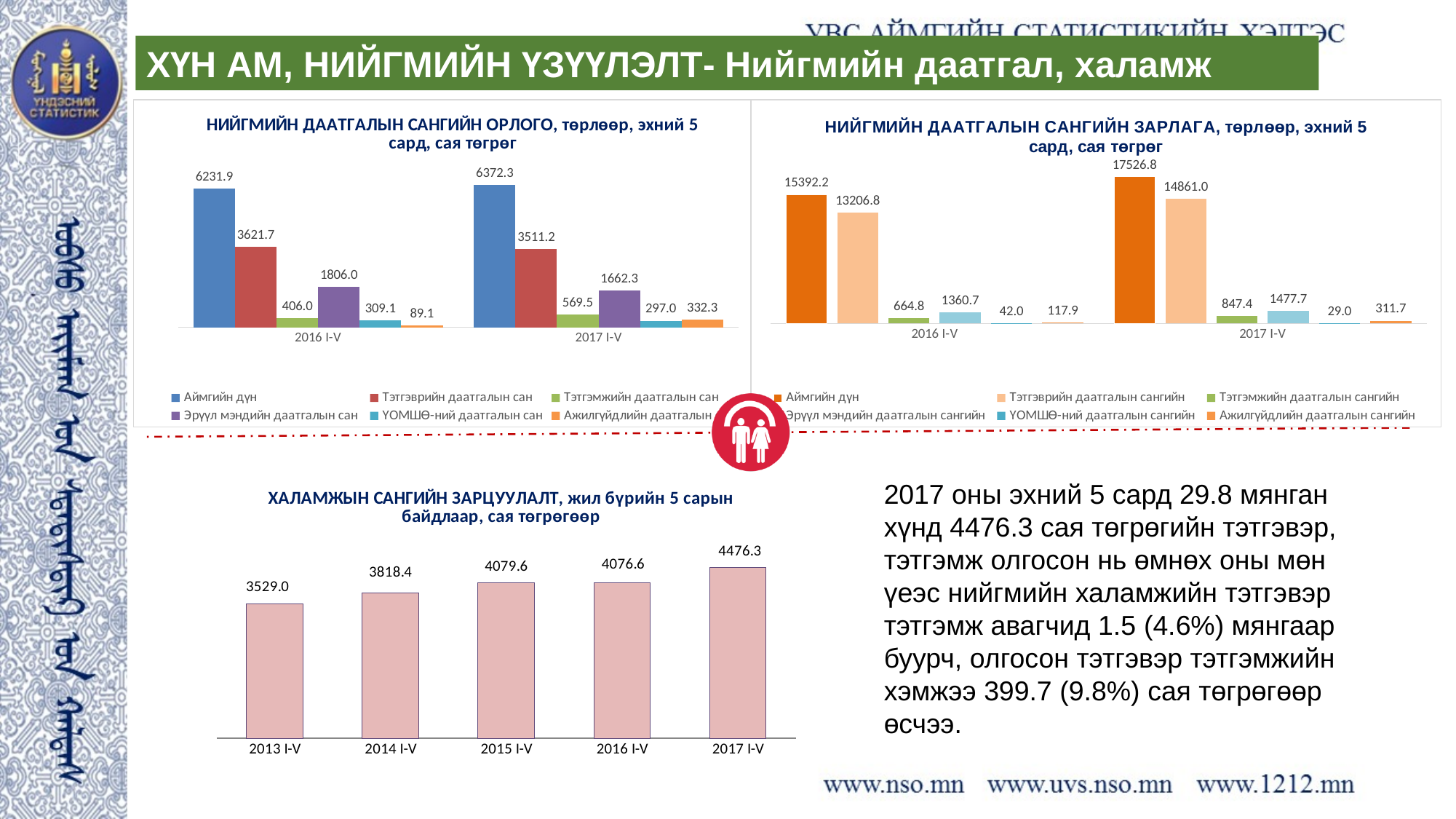
In the top-left chart (НИЙГМИЙН ДААТГАЛЫН САНГИЙН ОРЛОГО), what is the difference between the Тэтгэврийн даатгалын сан values for 2016 I-V and 2017 I-V? 110.5 In the top-right chart (НИЙГМИЙН ДААТГАЛЫН САНГИЙН ЗАРЛАГА), which series has the lowest value for 2017 I-V? ҮОМШӨ-ний даатгалын сангийн In the top-right chart (НИЙГМИЙН ДААТГАЛЫН САНГИЙН ЗАРЛАГА), what is the value of Аймгийн дүн for 2017 I-V? 17526.8 In the bottom chart (ХАЛАМЖЫН САНГИЙН ЗАРЦУУЛАЛТ), which year has the lowest value? 2013 I-V In the bottom chart (ХАЛАМЖЫН САНГИЙН ЗАРЦУУЛАЛТ), what is the value for 2017 I-V? 4476.3 In the top-left chart (НИЙГМИЙН ДААТГАЛЫН САНГИЙН ОРЛОГО), how many series does the legend list? 6 In the bottom chart (ХАЛАМЖЫН САНГИЙН ЗАРЦУУЛАЛТ), how many categories are shown on the x axis? 5 In the top-right chart (НИЙГМИЙН ДААТГАЛЫН САНГИЙН ЗАРЛАГА), what colour are the Аймгийн дүн bars? Orange In the top-left chart (НИЙГМИЙН ДААТГАЛЫН САНГИЙН ОРЛОГО), what is the value of Аймгийн дүн for 2017 I-V? 6372.3 What type of chart is the bottom chart (ХАЛАМЖЫН САНГИЙН ЗАРЦУУЛАЛТ)? Bar chart In the bottom chart (ХАЛАМЖЫН САНГИЙН ЗАРЦУУЛАЛТ), what is the difference between the 2017 I-V and 2016 I-V values? 399.7 In the top-left chart (НИЙГМИЙН ДААТГАЛЫН САНГИЙН ОРЛОГО), which is larger for 2016 I-V: Тэтгэврийн даатгалын сан or Эрүүл мэндийн даатгалын сан? Тэтгэврийн даатгалын сан